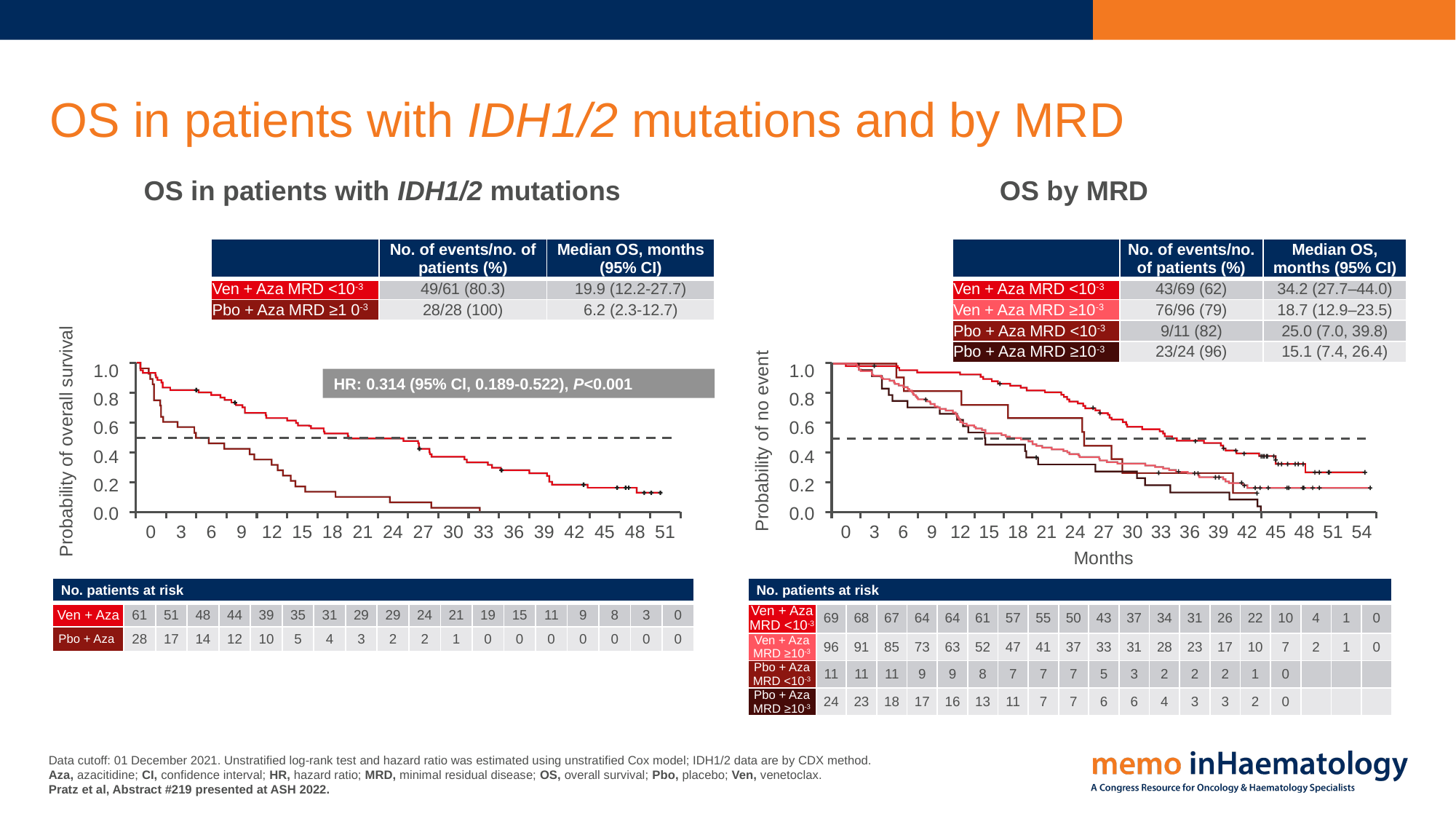
What is the y-axis label of the 'OS in patients with IDH1/2 mutations' chart? Probability of overall survival In the 'OS by MRD' chart, what is the median OS in months (95% CI) for Pbo + Aza MRD <10-3? 25.0 (7.0, 39.8) In the 'OS in patients with IDH1/2 mutations' chart, what is the hazard ratio shown in the grey box? HR: 0.314 (95% CI, 0.189-0.522), P<0.001 In the 'OS in patients with IDH1/2 mutations' chart, what is the number of events/number of patients (%) for Pbo + Aza? 28/28 (100) What kind of chart is the 'OS by MRD' chart? Line chart (Kaplan-Meier survival curve) In the 'OS by MRD' chart, which group has the lowest median OS? Pbo + Aza MRD ≥10-3 In the 'OS by MRD' chart, how many survival curves (groups) are plotted? 4 In the 'OS in patients with IDH1/2 mutations' chart, how many patients were at risk in the Ven + Aza group at month 0? 61 In the 'OS in patients with IDH1/2 mutations' chart, what is the difference in median OS (months) between the Ven + Aza and Pbo + Aza groups? 13.7 months In the 'OS in patients with IDH1/2 mutations' chart, what is the median OS in months (95% CI) for Ven + Aza MRD <10-3? 19.9 (12.2-27.7) In the 'OS by MRD' chart, is the probability of no event for Ven + Aza MRD <10-3 at 24 months greater or less than 0.6? greater In the 'OS by MRD' chart, which group has the highest median OS? Ven + Aza MRD <10-3